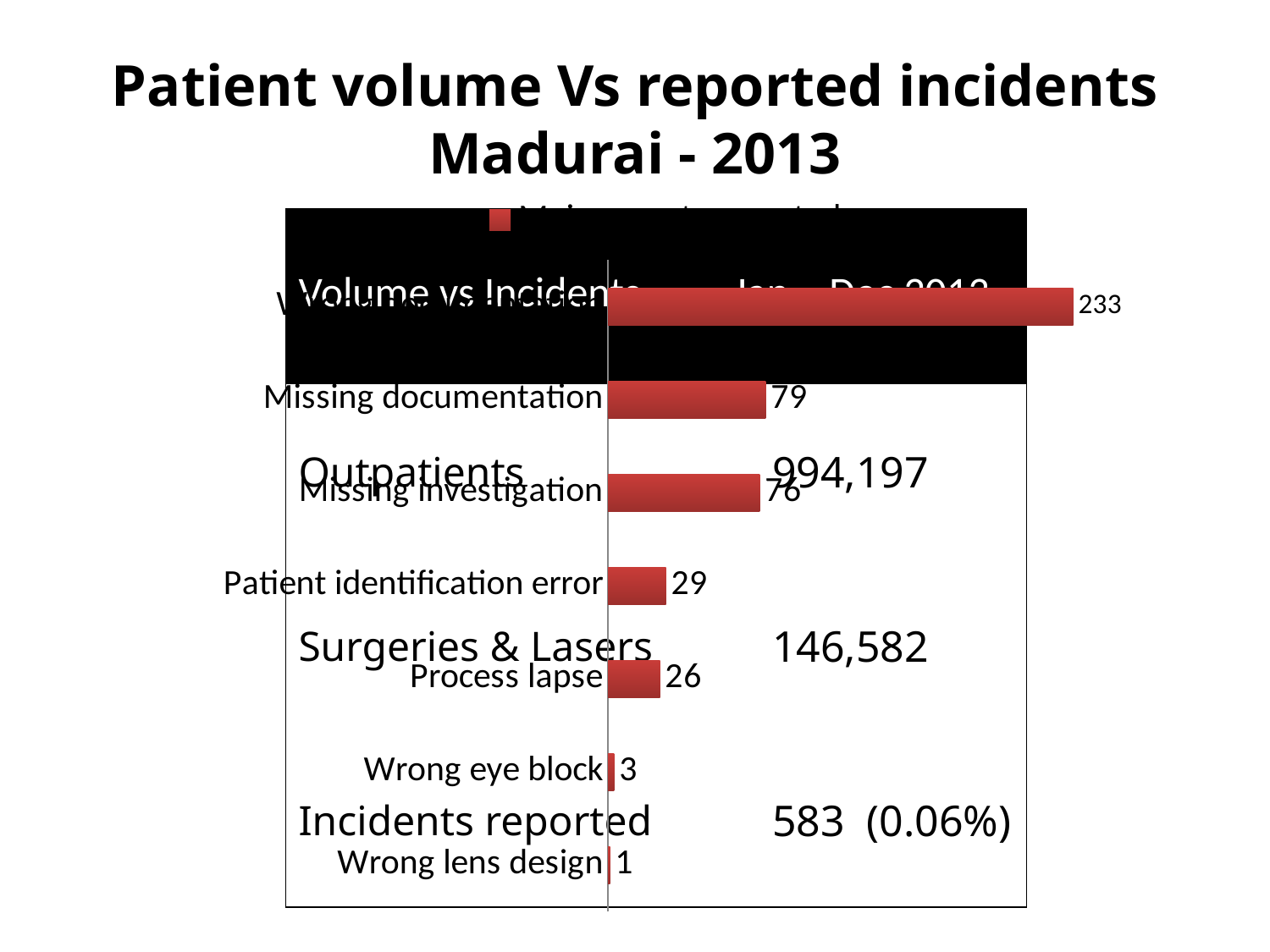
Which category has the lowest value? Wrong lens design What is the value for Patient identification error? 29 How many categories are plotted in the chart? 7 What is the value for Wrong eye block? 3 Which is larger, Patient identification error or Process lapse? Patient identification error What is the value for Process lapse? 26 What is the value for Wrong lens design? 1 What is the value for Missing documentation? 79 What is the value for Missing investigation? 76 What is the difference between Missing documentation and Missing investigation? 3 What kind of chart is shown on the slide? Bar chart What is the largest value labelled on the chart? 233